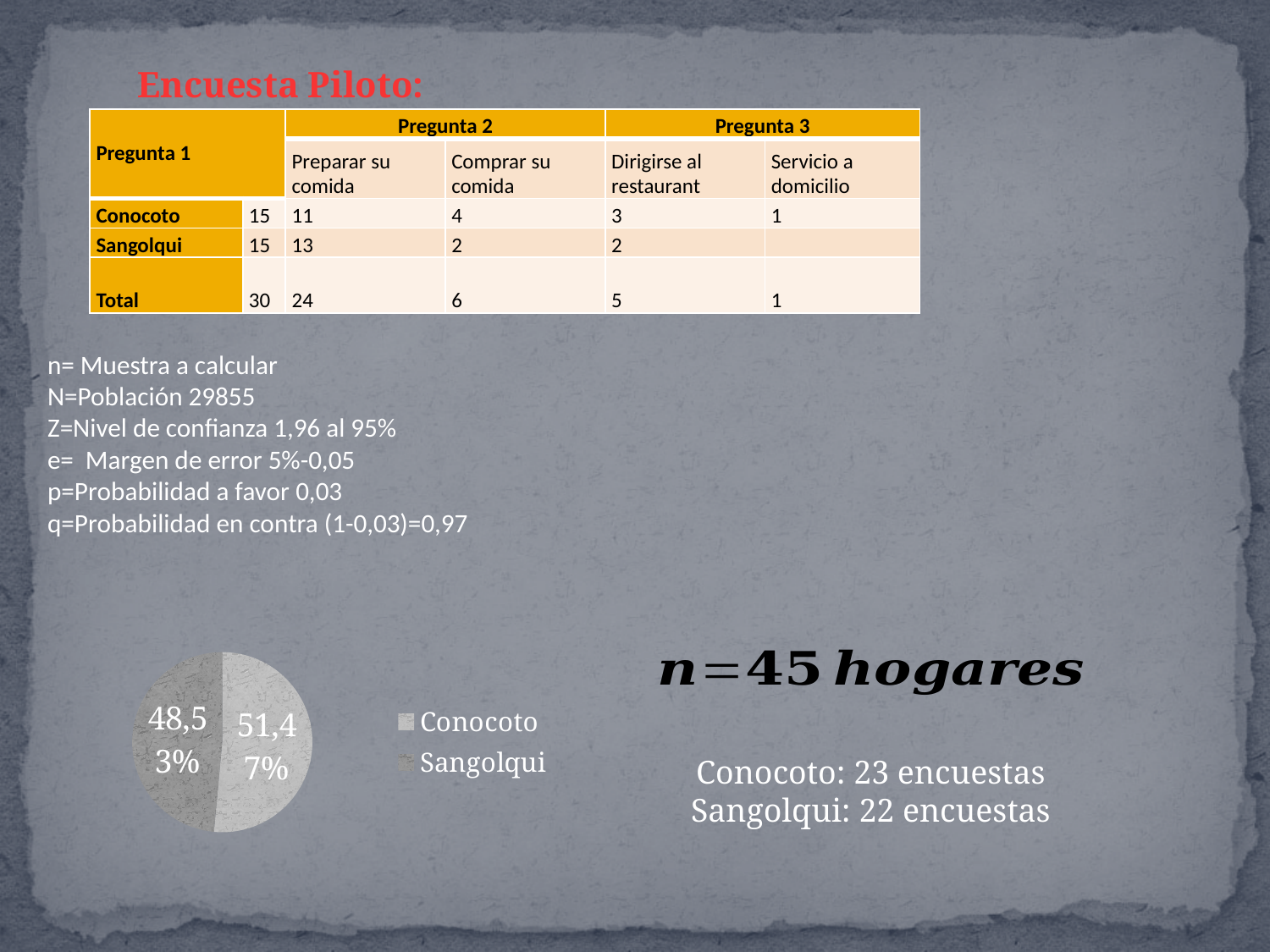
Which legend entry is listed first in the pie chart's legend? Conocoto What share of the pie chart does Conocoto represent? 51,47% Which slice of the pie chart is the smallest? Sangolqui What are the two legend entries of the pie chart? Conocoto and Sangolqui In the pie chart, which is larger, Conocoto or Sangolqui? Conocoto How many slices does the pie chart have? 2 What share of the pie chart does Sangolqui represent? 48,53% Which slice of the pie chart is the largest? Conocoto How many entries does the pie chart's legend list? 2 What is the difference in percentage points between the Conocoto and Sangolqui slices of the pie chart? 2,94% What kind of chart is shown at the bottom left of the slide? pie chart